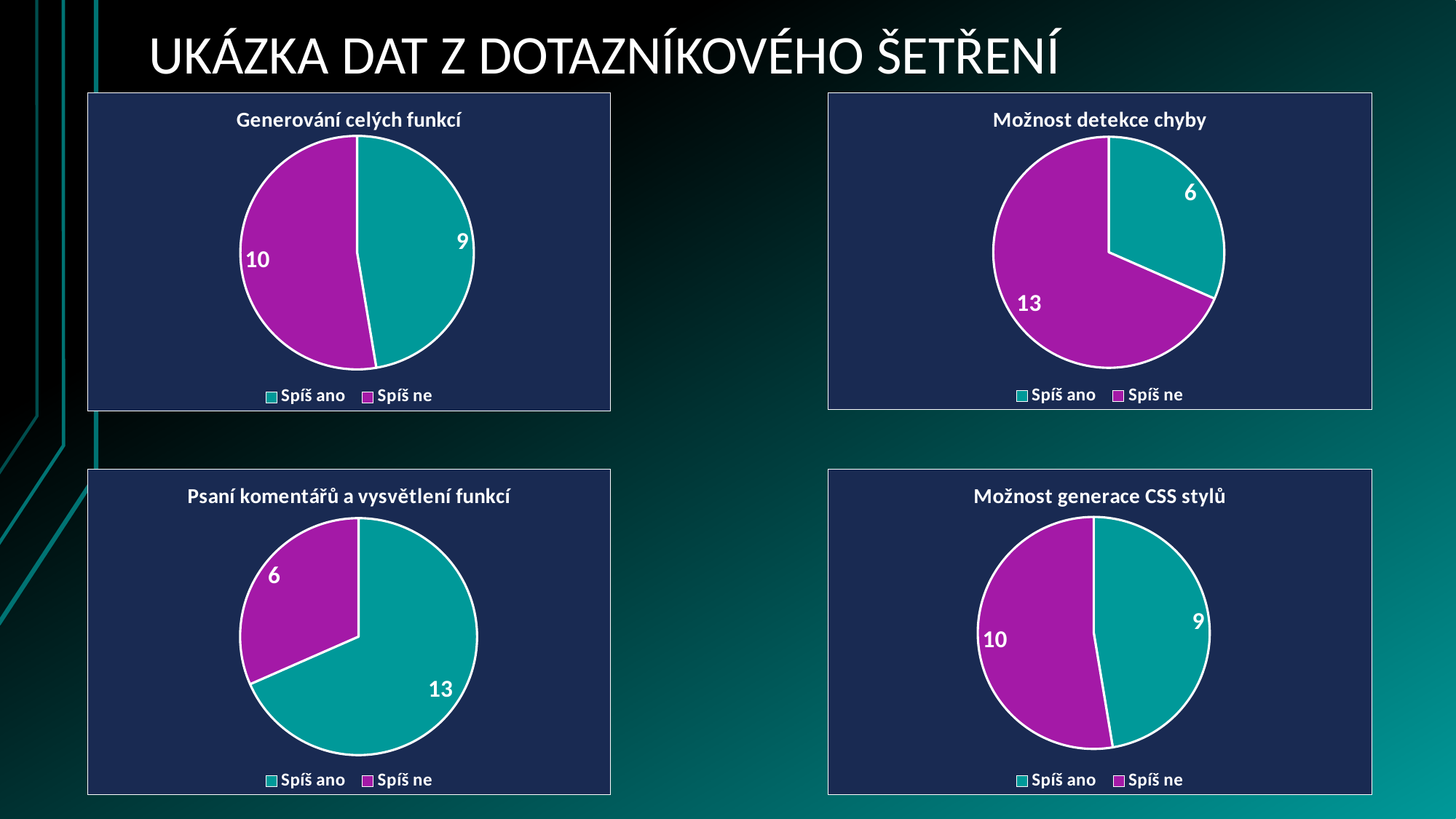
In the chart titled "Psaní komentářů a vysvětlení funkcí", which slice is the smallest? Spíš ne In the chart titled "Generování celých funkcí", what is the value for "Spíš ano"? 9 What kind of chart is the chart titled "Generování celých funkcí"? Pie chart In the chart titled "Generování celých funkcí", what is the value for "Spíš ne"? 10 In the chart titled "Možnost detekce chyby", which slice is the largest? Spíš ne In the chart titled "Psaní komentářů a vysvětlení funkcí", what is the difference between "Spíš ano" and "Spíš ne"? 7 In the chart titled "Možnost generace CSS stylů", which is larger, "Spíš ano" or "Spíš ne"? Spíš ne How many entries does the legend of the chart titled "Možnost generace CSS stylů" list? 2 In the chart titled "Možnost detekce chyby", what is the value for "Spíš ne"? 13 In the chart titled "Psaní komentářů a vysvětlení funkcí", what is the value for "Spíš ano"? 13 In the chart titled "Možnost generace CSS stylů", what is the total of all slices? 19